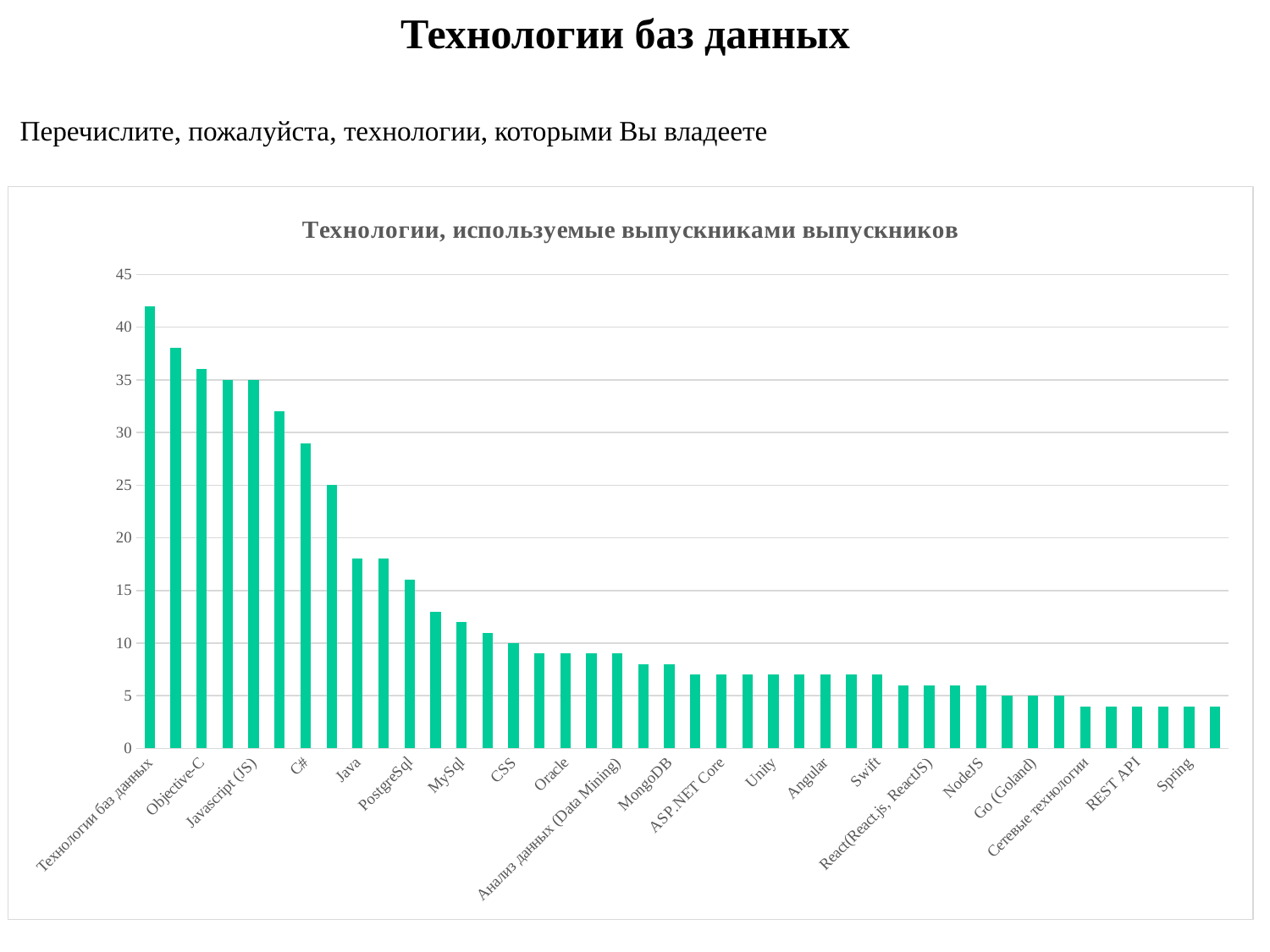
Is the value for PostgreSql greater or less than 15? greater Is the value for C# greater or less than 30? less What is the title of the chart? Технологии, используемые выпускниками выпускников Which category has the highest value in the chart? Технологии баз данных What kind of chart is shown on the slide? Bar chart Which is larger, the value for MySql or the value for Spring? MySql Do the values rise or fall from left to right along the x axis? fall Which is larger, the value for Objective-C or the value for Java? Objective-C Is the value for Технологии баз данных greater or less than 40? greater What colour are the bars in the chart? Green